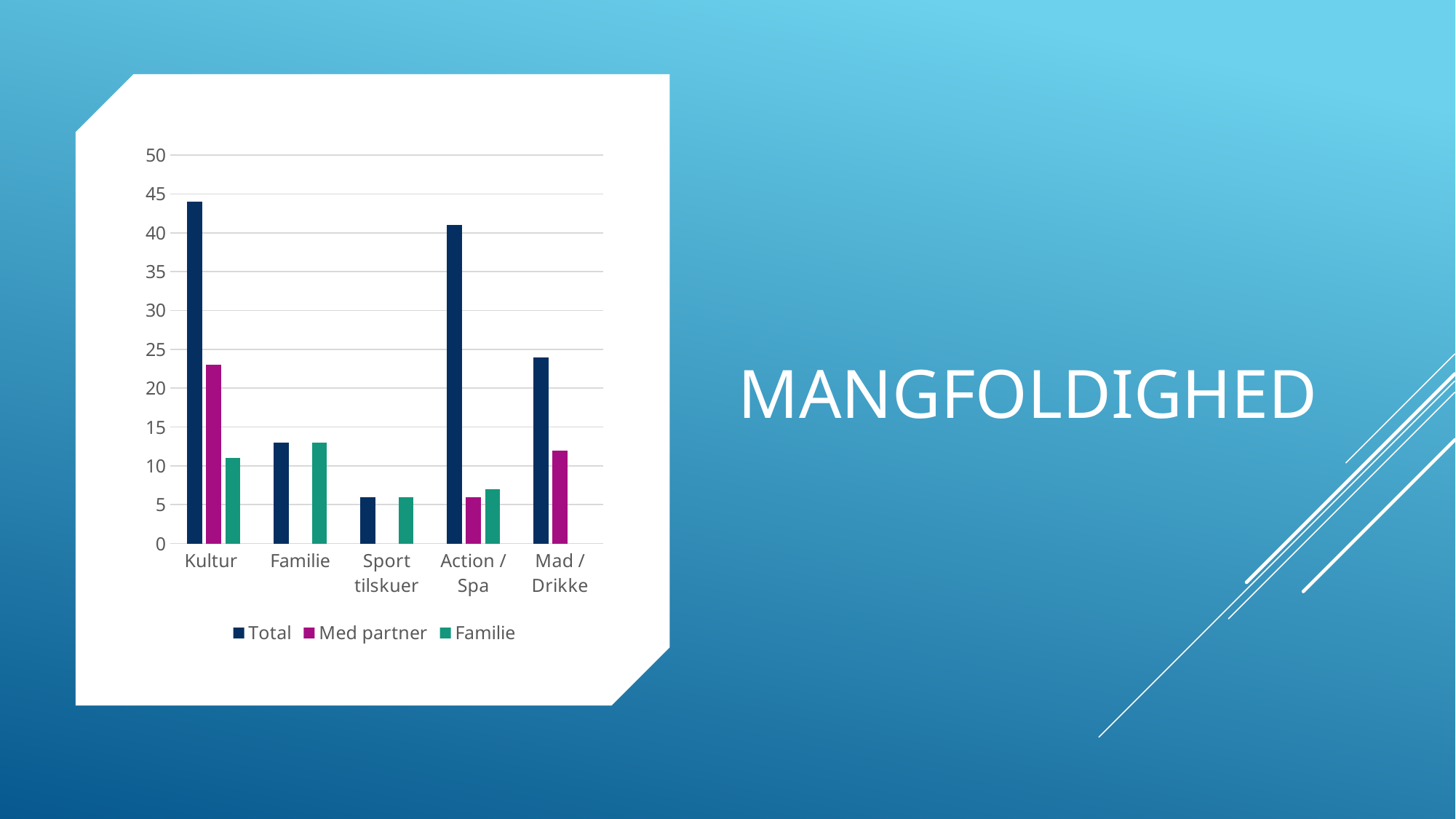
Is the Total value for Kultur greater or less than 40? greater What kind of chart is shown on the slide? Bar chart Which is larger, the Total value for Kultur or the Total value for Action / Spa? Kultur Which is larger, the Total value for Mad / Drikke or the Total value for Familie? Mad / Drikke How many categories are shown on the x axis of the chart? 5 Which category has the highest Total value? Kultur How many series does the chart legend list? 3 Which series is shown in green in the chart legend? Familie Which category has the highest Med partner value? Kultur Is the Total value for Sport tilskuer greater or less than 10? less Is the Med partner value for Kultur greater or less than 20? greater Which category has the lowest Total value? Sport tilskuer